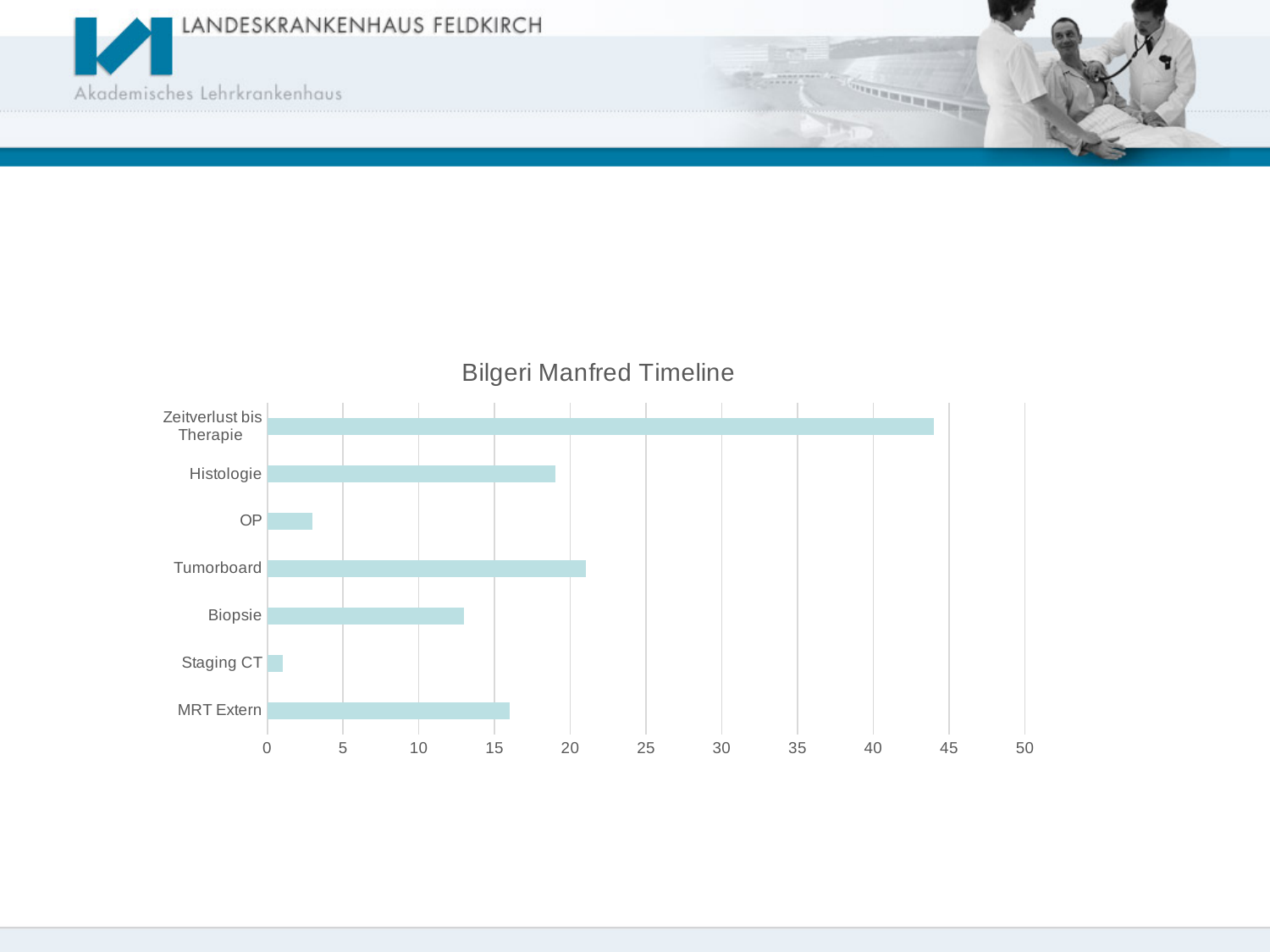
Is the value for OP greater or less than 5? less Which is larger, the value for MRT Extern or the value for OP? MRT Extern What is the title of the chart? Bilgeri Manfred Timeline How many categories are plotted in the chart? 7 What kind of chart is shown on the slide? bar chart Which is larger, the value for Tumorboard or the value for Biopsie? Tumorboard Is the value for Histologie greater or less than 20? less Is the value for Biopsie greater or less than 10? greater Which category has the highest value? Zeitverlust bis Therapie Which category has the lowest value? Staging CT